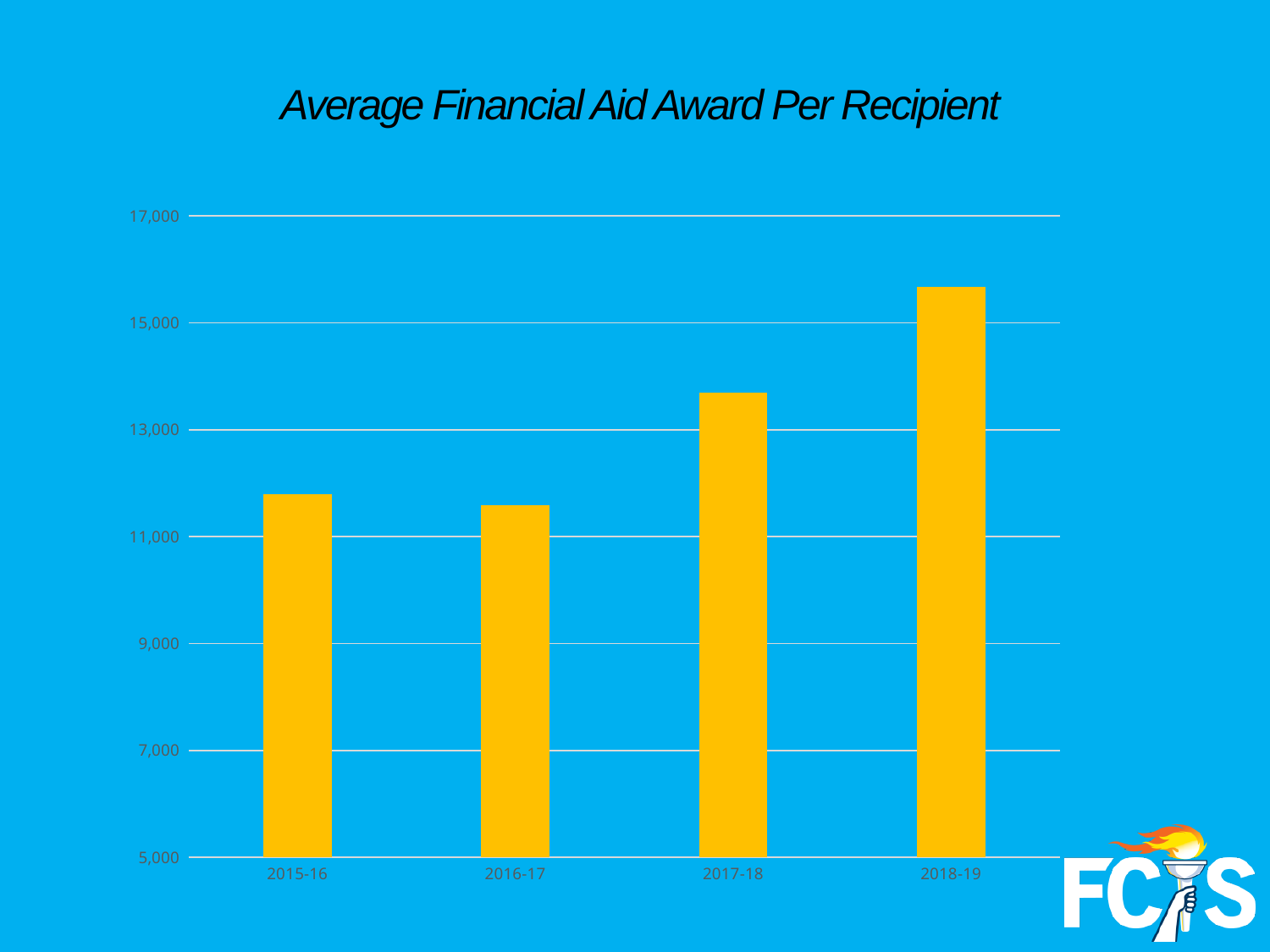
What kind of chart is shown on the slide? bar chart Is the value for 2015-16 greater or less than 13,000? less Is the value for 2017-18 greater or less than 13,000? greater Is the value for 2017-18 greater or less than 15,000? less What is the title of the chart? Average Financial Aid Award Per Recipient Which academic year has the highest average financial aid award per recipient? 2018-19 What is the lowest value shown on the vertical axis? 5,000 How many academic years are shown on the x axis? 4 Which is larger, the value for 2017-18 or the value for 2018-19? 2018-19 Which is larger, the value for 2016-17 or the value for 2017-18? 2017-18